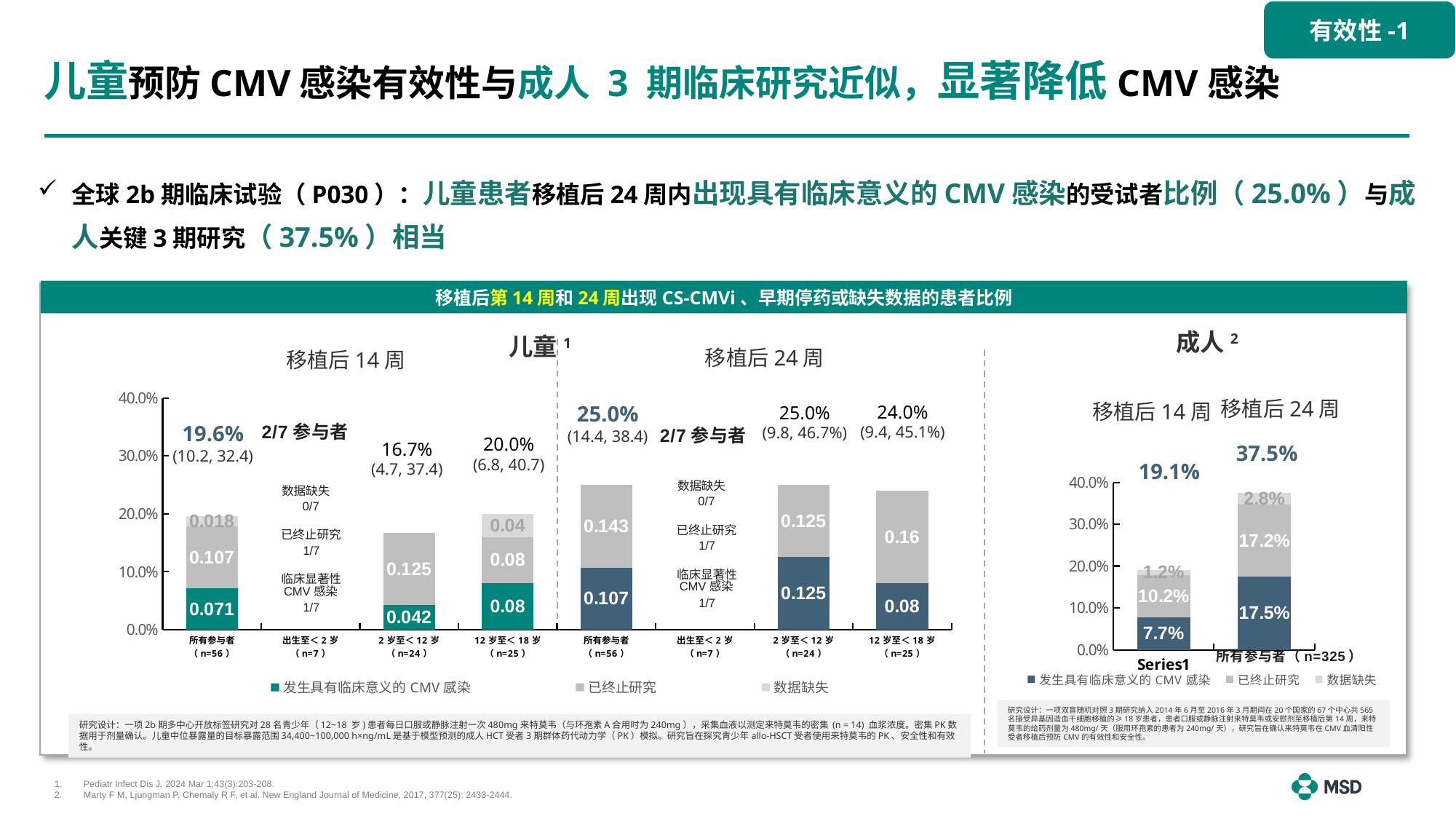
In the 儿童 移植后 24 周 chart, what total percentage is printed above the 所有参与者 (n=56) bar? 25.0% In the 成人 chart, what is the difference between the 移植后 24 周 total (37.5%) and the 移植后 14 周 total (19.1%)? 18.4% In the 儿童 移植后 24 周 chart, what is the 发生具有临床意义的 CMV 感染 value for 12 岁至< 18 岁 (n=25)? 0.08 What kind of chart is the 成人 chart? Stacked bar chart In the 儿童 移植后 14 周 chart, what is the 发生具有临床意义的 CMV 感染 value for 所有参与者 (n=56)? 0.071 In the 成人 chart, what is the 数据缺失 value for 移植后 14 周? 1.2% In the 儿童 移植后 24 周 chart, what is the 已终止研究 value for 所有参与者 (n=56)? 0.143 How many series does the legend of the 儿童 charts list? 3 In the 成人 chart, which bar is taller, 移植后 14 周 or 移植后 24 周? 移植后 24 周 In the 儿童 移植后 14 周 chart, what total percentage is printed above the 12 岁至< 18 岁 (n=25) bar? 20.0% In the 儿童 移植后 14 周 chart, what is the 已终止研究 value for 2 岁至< 12 岁 (n=24)? 0.125 In the 成人 chart, what is the 发生具有临床意义的 CMV 感染 value for 移植后 24 周? 17.5%